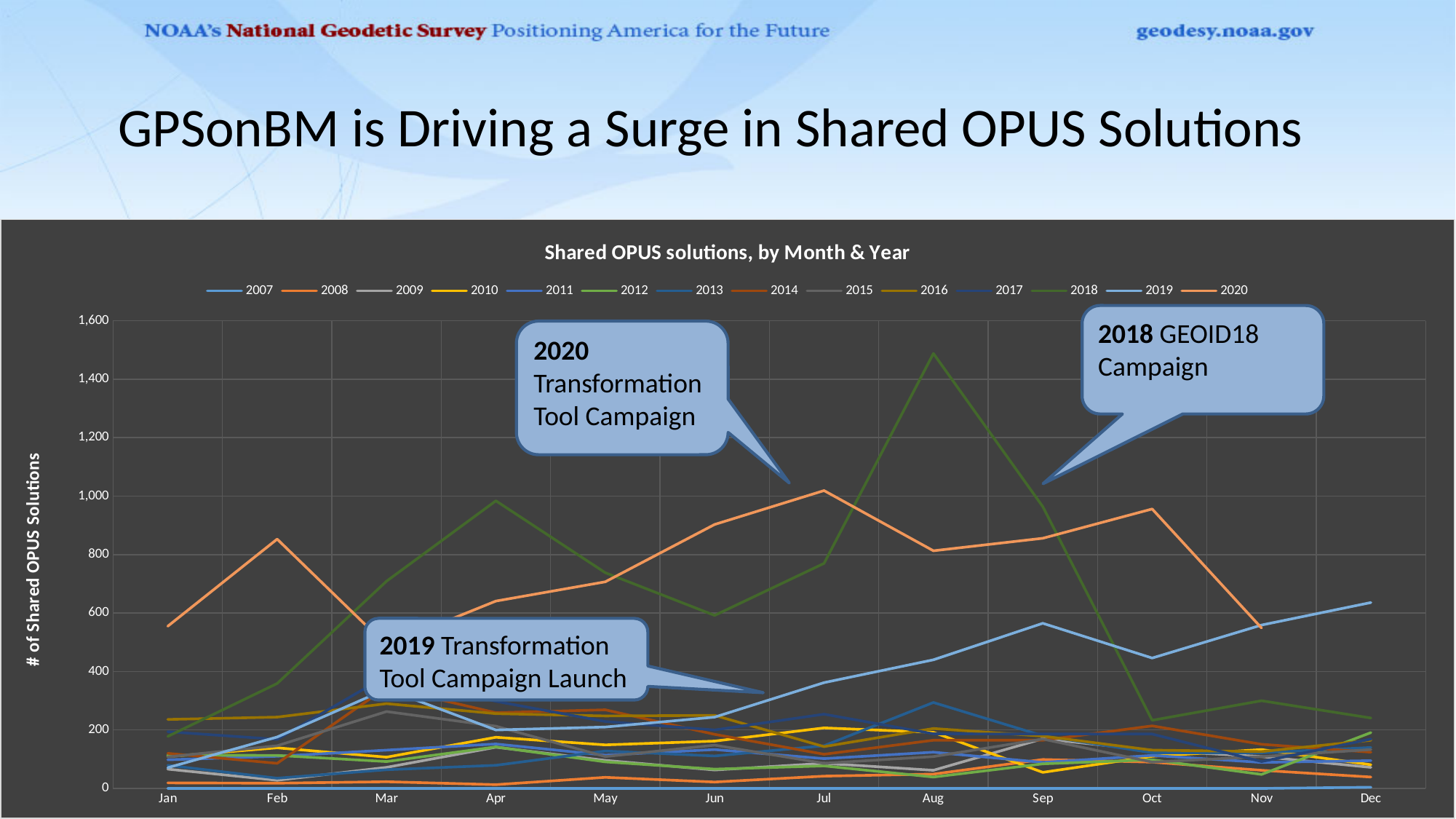
What kind of chart is shown on the slide? line chart Which is larger: the 2018 value in Aug or the 2020 value in Jul? 2018 in Aug Is the value for 2018 in Oct greater or less than 400? less In which month does the 2020 series reach its highest value? Jul Is the value for 2018 in Aug greater or less than 1,400? greater How many series does the legend list? 14 Does the 2018 series rise or fall from Aug to Oct? fall How many months are shown along the x axis? 12 Is the value for 2020 in Jul greater or less than 800? greater In which month does the 2018 series reach its highest value? Aug What is the label on the y axis? # of Shared OPUS Solutions What is the title of the chart? Shared OPUS solutions, by Month & Year